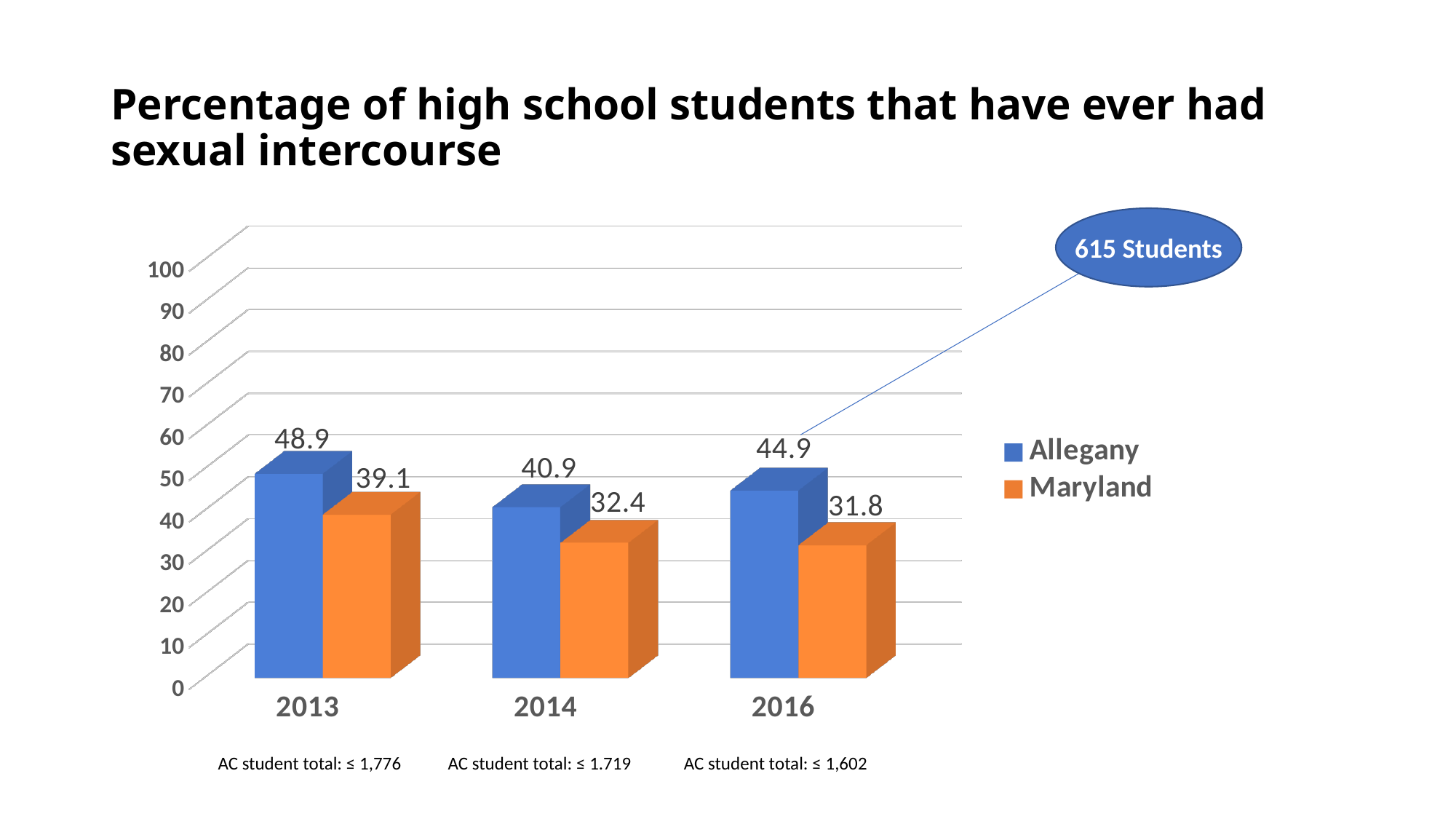
How many years are shown on the x axis? 3 What kind of chart is shown on the slide? Bar chart What does the callout bubble pointing to the 2016 Allegany bar say? 615 Students What is the value for Allegany in 2016? 44.9 In which year is the Allegany value highest? 2013 What is the value for Maryland in 2014? 32.4 What is the difference between the Allegany and Maryland values in 2013? 9.8 How many series does the legend list? 2 What is the value for Maryland in 2016? 31.8 What is the value for Allegany in 2013? 48.9 Which is larger in 2014, the Allegany value or the Maryland value? Allegany In which year is the Maryland value lowest? 2016